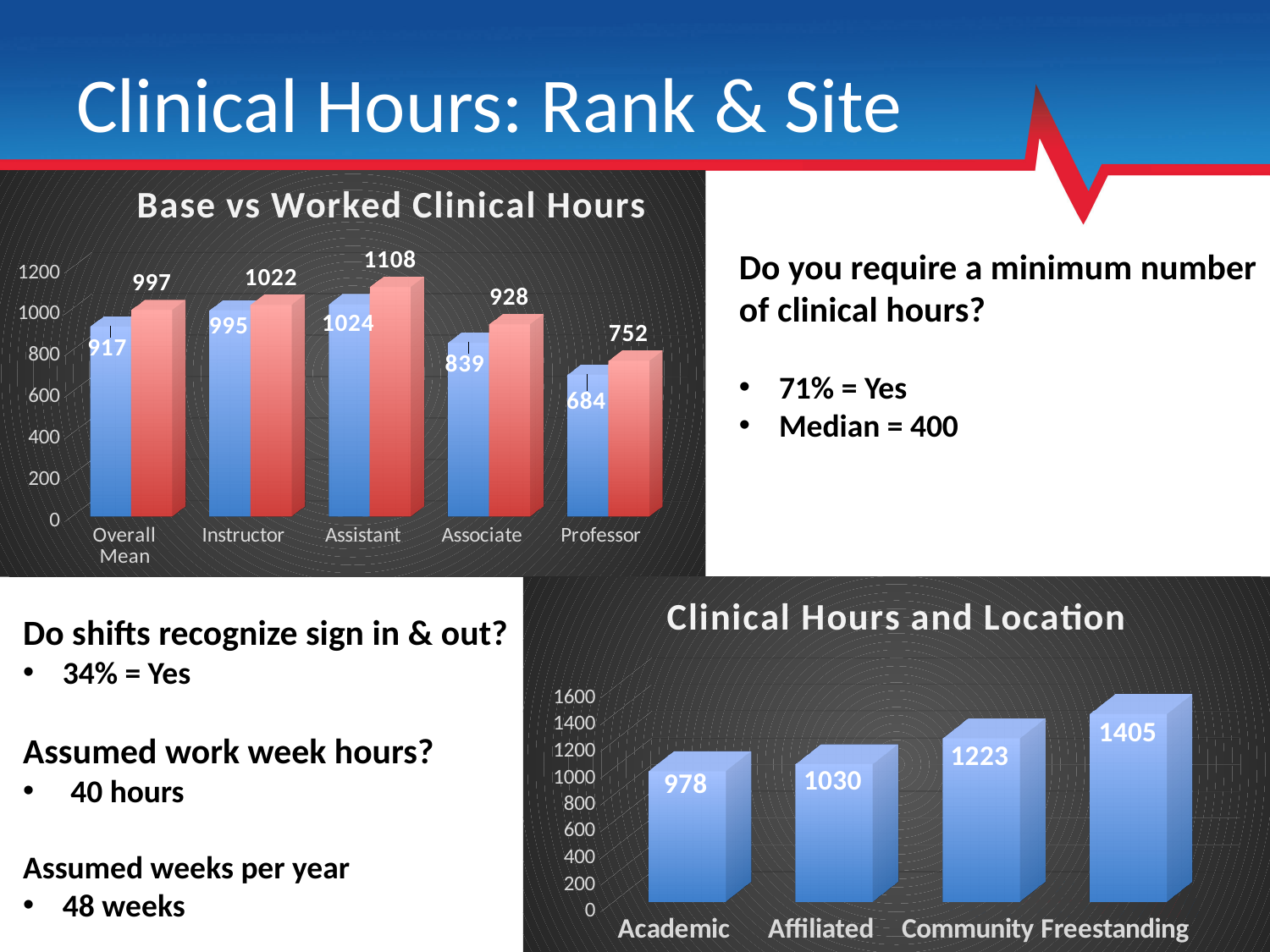
In the 'Base vs Worked Clinical Hours' chart, what is the value of the blue bar for Professor? 684 In the 'Clinical Hours and Location' chart, what is the difference between Freestanding and Academic? 427 In the 'Base vs Worked Clinical Hours' chart, how many categories are shown on the x axis? 5 In the 'Base vs Worked Clinical Hours' chart, what is the difference between the red and blue bars for Associate? 89 In the 'Base vs Worked Clinical Hours' chart, which category has the highest blue bar? Assistant In the 'Base vs Worked Clinical Hours' chart, is the blue bar for Overall Mean greater or less than 1000? less In the 'Base vs Worked Clinical Hours' chart, which category has the lowest red bar? Professor In the 'Clinical Hours and Location' chart, what is the value for Community? 1223 In the 'Clinical Hours and Location' chart, do the values rise or fall from Academic to Freestanding? rise In the 'Base vs Worked Clinical Hours' chart, what is the value of the red bar for Assistant? 1108 In the 'Clinical Hours and Location' chart, which location has the highest value? Freestanding What kind of chart is 'Clinical Hours and Location'? bar chart